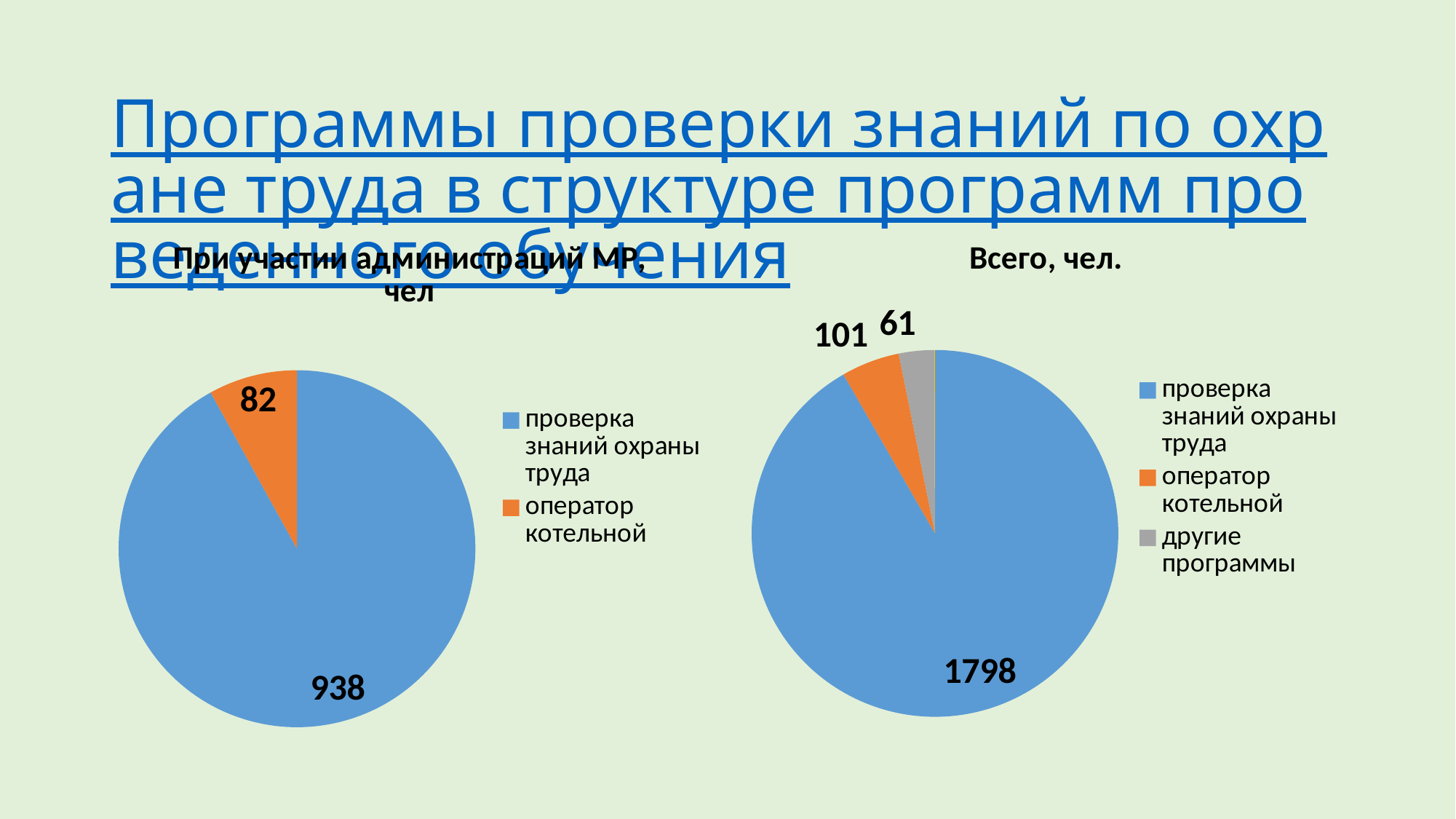
What kind of chart is the left chart titled 'При участии администраций МР, чел'? pie chart In the right chart ('Всего, чел.'), which category has the smallest value? другие программы In the right chart ('Всего, чел.'), what colour is the slice for 'другие программы'? grey In the right chart ('Всего, чел.'), what is the difference between the values for 'оператор котельной' and 'другие программы'? 40 How many categories does the right chart ('Всего, чел.') show? 3 In the right chart ('Всего, чел.'), what is the value for 'другие программы'? 61 In the left chart ('При участии администраций МР, чел'), what is the value for 'проверка знаний охраны труда'? 938 In the left chart ('При участии администраций МР, чел'), what is the difference between the values for 'проверка знаний охраны труда' and 'оператор котельной'? 856 In the right chart ('Всего, чел.'), what is the value for 'проверка знаний охраны труда'? 1798 In the left chart ('При участии администраций МР, чел'), which category has the largest value? проверка знаний охраны труда In the left chart ('При участии администраций МР, чел'), what is the value for 'оператор котельной'? 82 In the right chart ('Всего, чел.'), what is the value for 'оператор котельной'? 101